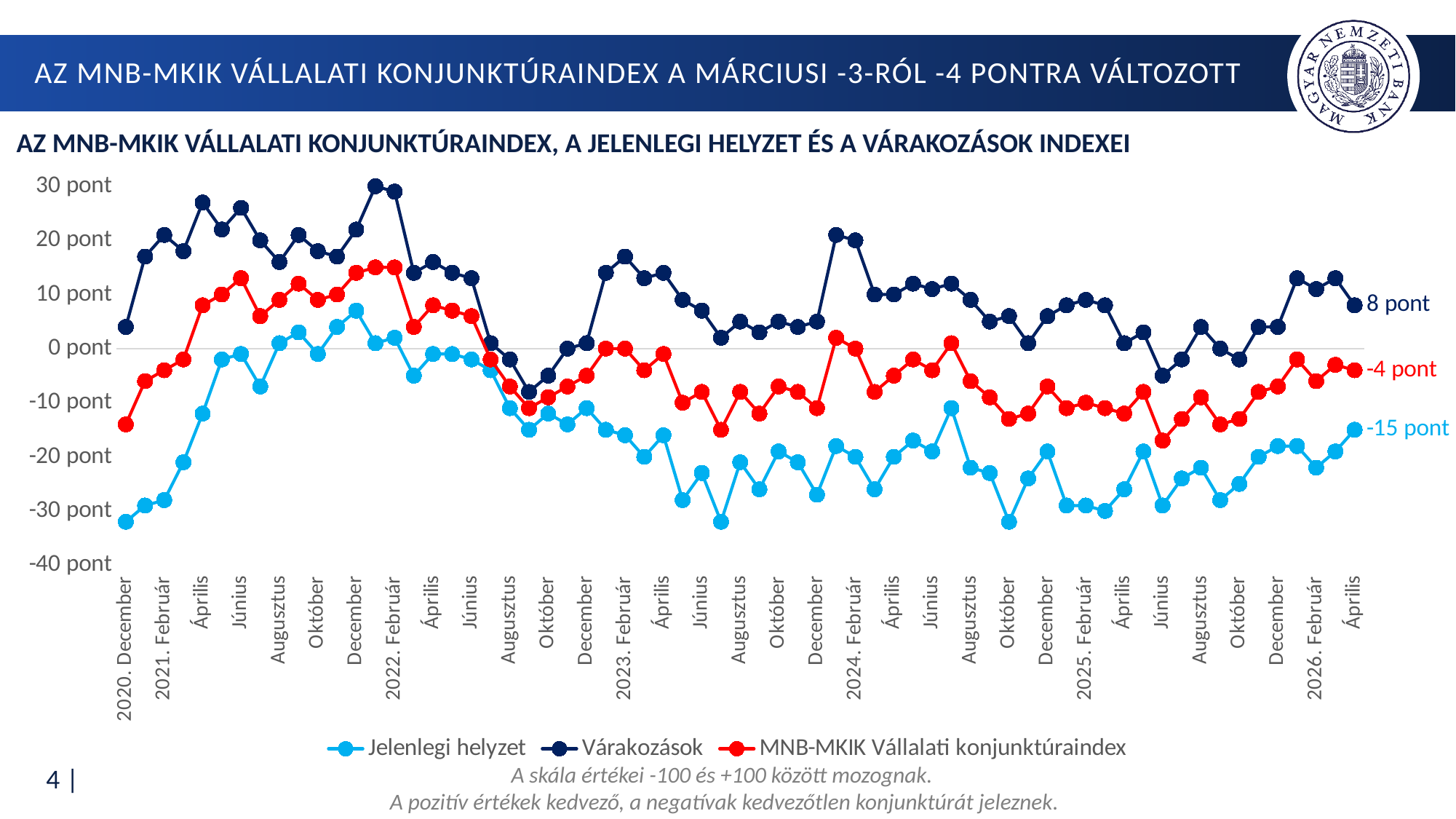
At the last point (2026 Április), which series has the highest value? Várakozások Is the value of the Jelenlegi helyzet series in 2020 December greater or less than -30 pont? less Which colour is used for the Jelenlegi helyzet series? light blue What is the value of the Várakozások series at the last point (2026 Április)? 8 pont What kind of chart is shown on the slide? line chart How many series does the legend list? 3 What is the value of the MNB-MKIK Vállalati konjunktúraindex at the last point (2026 Április)? -4 pont What is the value of the Jelenlegi helyzet series at the last point (2026 Április)? -15 pont What is the difference between the MNB-MKIK Vállalati konjunktúraindex (-4 pont) and the Jelenlegi helyzet (-15 pont) at the last point? 11 pont At the last point (2026 Április), which series has the lowest value? Jelenlegi helyzet What is the difference between the Várakozások value (8 pont) and the Jelenlegi helyzet value (-15 pont) at the last point? 23 pont Is the value of the Várakozások series in 2021 Április greater or less than 20 pont? greater